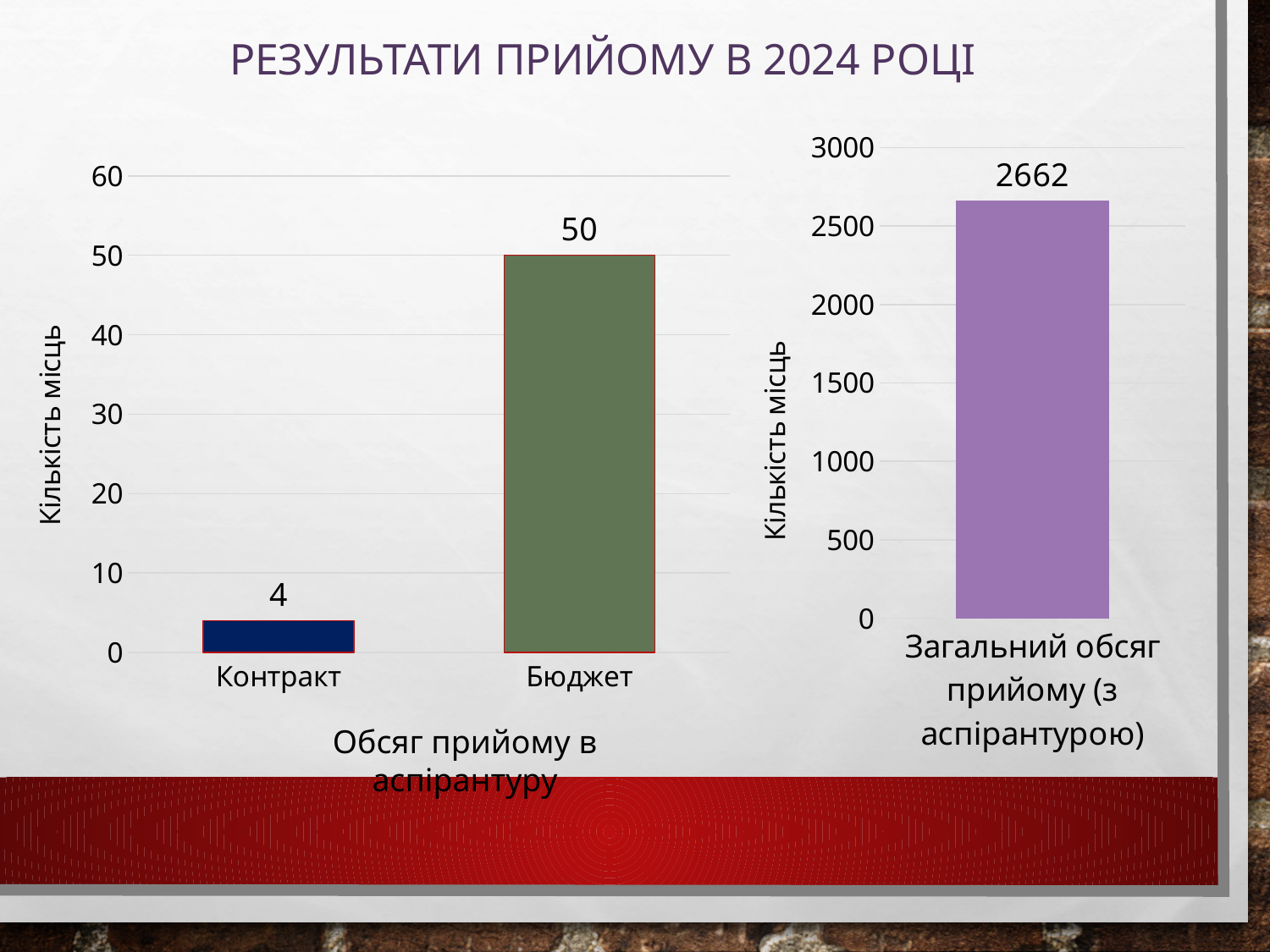
What is the y-axis label of the left chart (Обсяг прийому в аспірантуру)? Кількість місць In the left chart (Обсяг прийому в аспірантуру), what is the value for Бюджет? 50 In the left chart (Обсяг прийому в аспірантуру), what is the value for Контракт? 4 What is the title of the slide? РЕЗУЛЬТАТИ ПРИЙОМУ В 2024 РОЦІ In the left chart (Обсяг прийому в аспірантуру), which category has the highest value? Бюджет In the left chart (Обсяг прийому в аспірантуру), what is the difference between the values for Бюджет and Контракт? 46 What kind of chart is the right chart (Загальний обсяг прийому (з аспірантурою))? bar chart In the left chart (Обсяг прийому в аспірантуру), which category has the lowest value? Контракт In the right chart (Загальний обсяг прийому (з аспірантурою)), what value is shown on the bar? 2662 In the right chart (Загальний обсяг прийому (з аспірантурою)), is the value of the bar greater or less than 2500? greater In the left chart (Обсяг прийому в аспірантуру), which is larger: the value for Контракт or the value for Бюджет? Бюджет How many categories are shown in the left chart (Обсяг прийому в аспірантуру)? 2